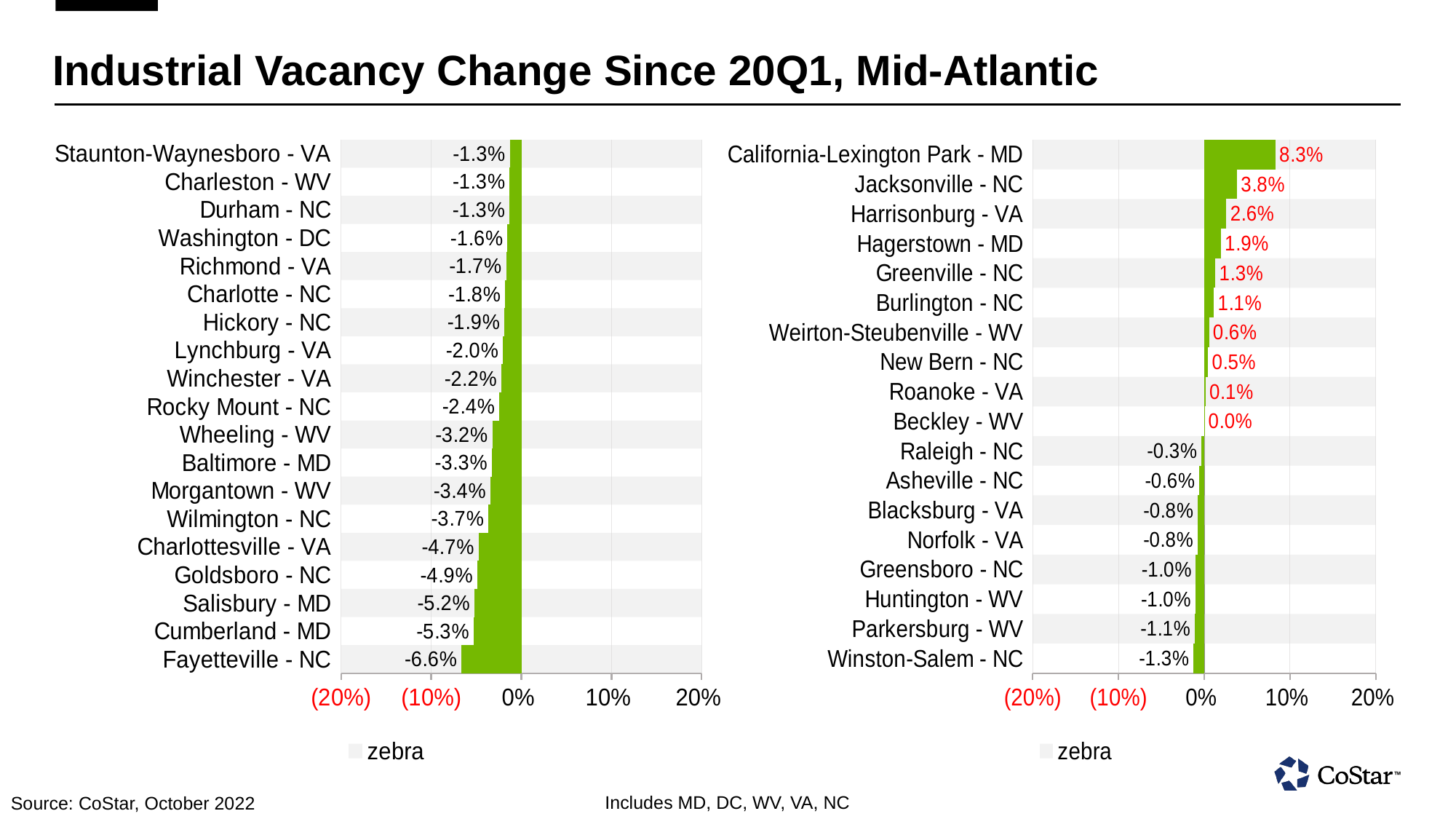
On the left chart, which market has the lowest value? Fayetteville - NC On the right chart, which market has the highest value? California-Lexington Park - MD What is the title of the slide containing the two charts? Industrial Vacancy Change Since 20Q1, Mid-Atlantic On the left chart, what is the value for Fayetteville - NC? -6.6% On the left chart, what is the value for Baltimore - MD? -3.3% On the right chart, what is the value for California-Lexington Park - MD? 8.3% On the right chart, what is the difference between the values for Jacksonville - NC and Harrisonburg - VA? 1.2% How many markets are shown on the right chart? 18 What kind of chart is the right chart? Bar chart On the right chart, what is the value for Roanoke - VA? 0.1% On the left chart, which is larger, the value for Wheeling - WV or the value for Charlottesville - VA? Wheeling - WV How many markets are shown on the left chart? 19